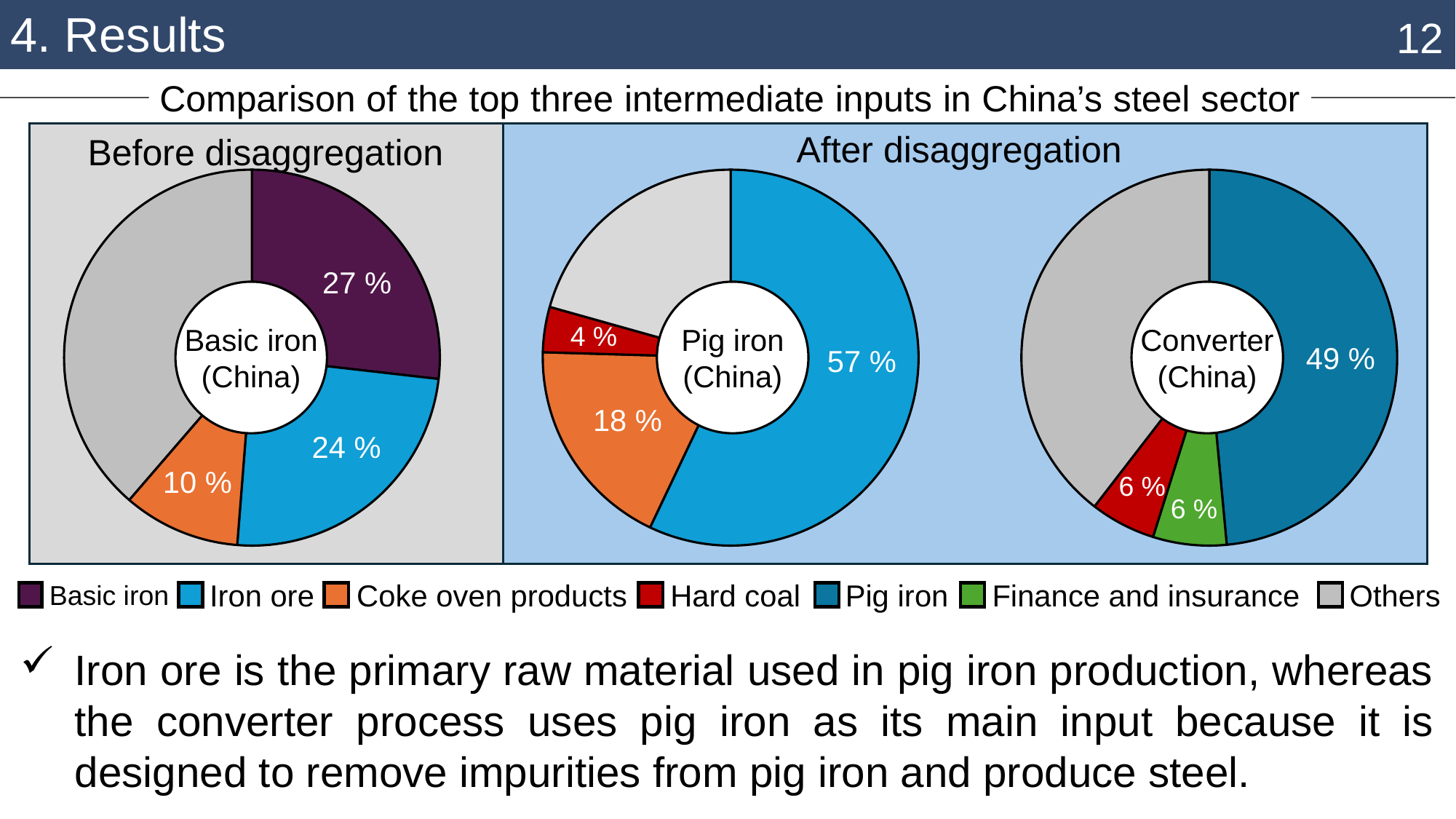
In the Pig iron (China) chart, what share does Hard coal have? 4 % In the Basic iron (China) chart, which is larger: the Basic iron share or the Iron ore share? Basic iron In the Converter (China) chart, what share does Pig iron have? 49 % In the Pig iron (China) chart, what is the difference between the Iron ore share and the Coke oven products share? 39 % How many pie charts are shown on the slide? 3 In the Basic iron (China) chart, what share do Coke oven products have? 10 % How many entries does the legend list? 7 In the Pig iron (China) chart, what share does Iron ore have? 57 % What kind of charts are shown on the slide? Pie (donut) charts In the Basic iron (China) chart, what share does Basic iron have? 27 % In the Basic iron (China) chart, what share does Iron ore have? 24 % In the Pig iron (China) chart, which input has the largest share? Iron ore